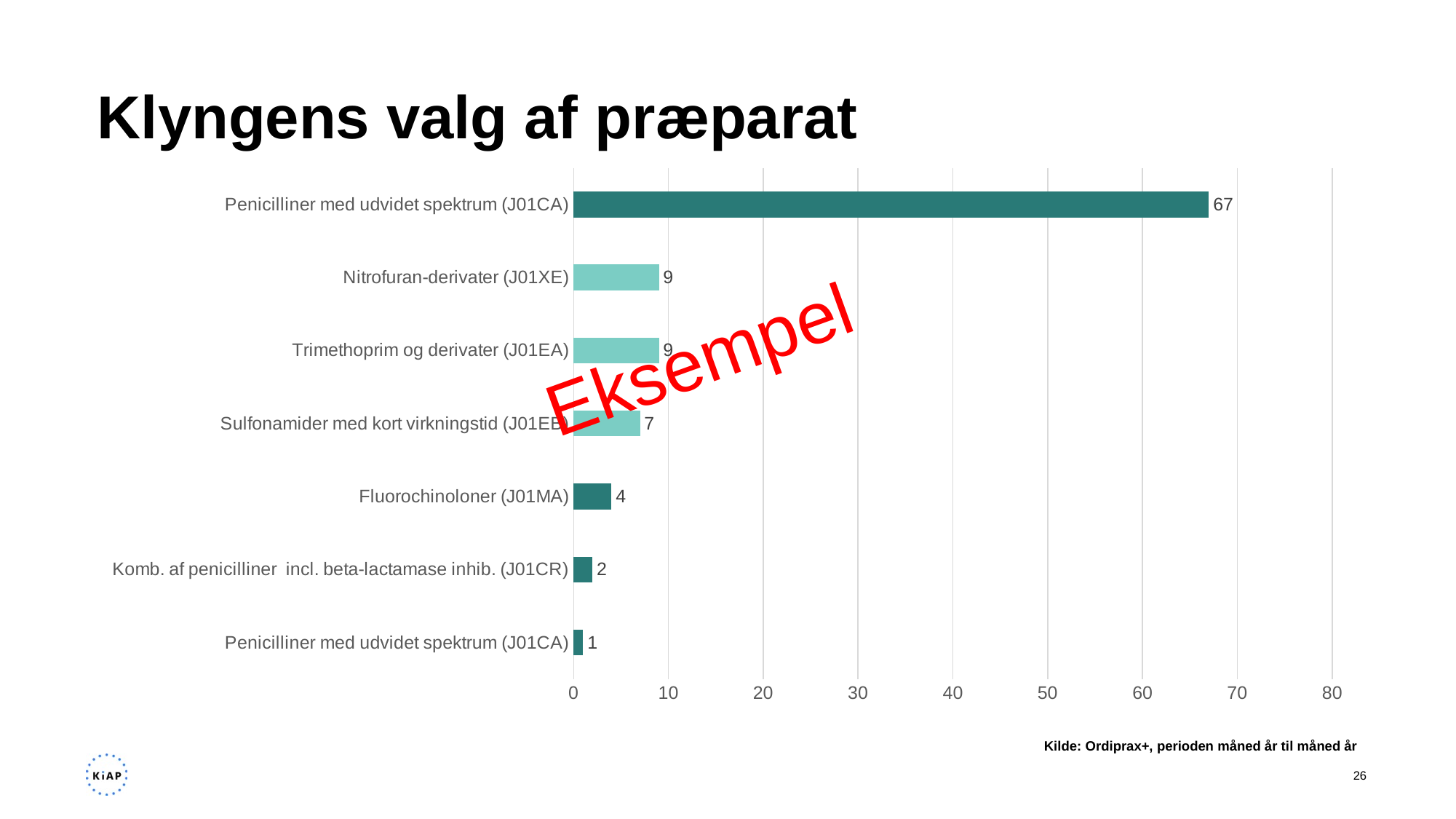
What is the value of the topmost bar, labelled Penicilliner med udvidet spektrum (J01CA)? 67 What is the value for Fluorochinoloner (J01MA)? 4 What is the value for Trimethoprim og derivater (J01EA)? 9 What is the value for Sulfonamider med kort virkningstid? 7 What is the difference between the topmost bar (67) and Nitrofuran-derivater (J01XE)? 58 What is the value for Komb. af penicilliner incl. beta-lactamase inhib. (J01CR)? 2 Which is larger, Fluorochinoloner (J01MA) or Sulfonamider med kort virkningstid? Sulfonamider med kort virkningstid What is the title of the slide? Klyngens valg af præparat What is the value of the bottom bar in the chart? 1 What is the value for Nitrofuran-derivater (J01XE)? 9 What type of chart is shown on the slide? Bar chart How many bars are shown in the chart? 7